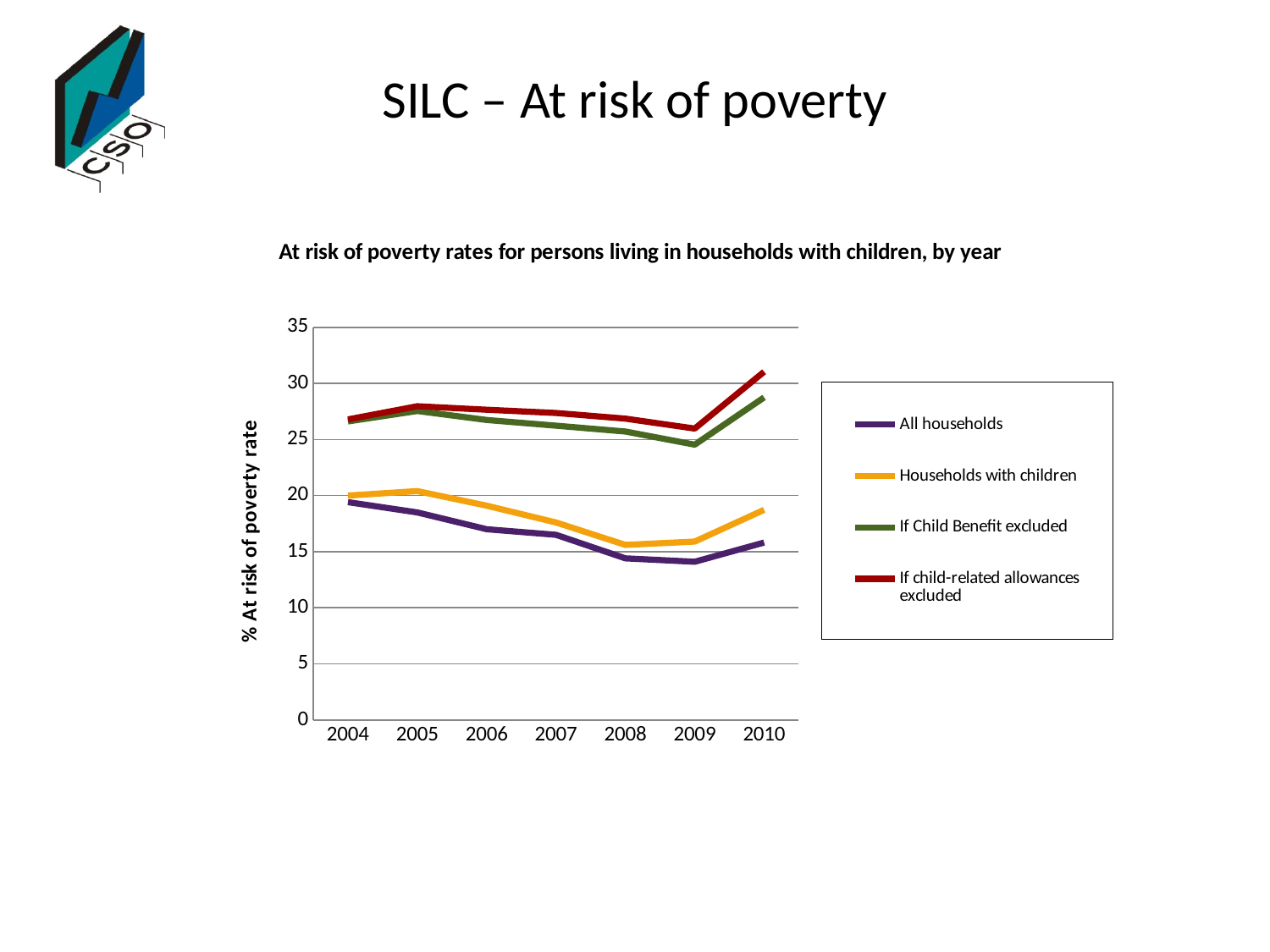
Is the value for Households with children in 2010 greater or less than 20? less Is the value for If Child Benefit excluded in 2010 greater or less than 25? greater In 2010, which is larger: All households or Households with children? Households with children Does the All households series rise or fall from 2004 to 2009? Fall Which series has the highest value in 2010? If child-related allowances excluded In which year is the If Child Benefit excluded series at its lowest? 2009 In which year is the If child-related allowances excluded series at its highest? 2010 Is the value for All households in 2009 greater or less than 15? less What kind of chart is shown on the slide? Line chart How many years are plotted along the x axis? 7 What is the label on the y axis of the chart? % At risk of poverty rate How many series does the legend list? 4